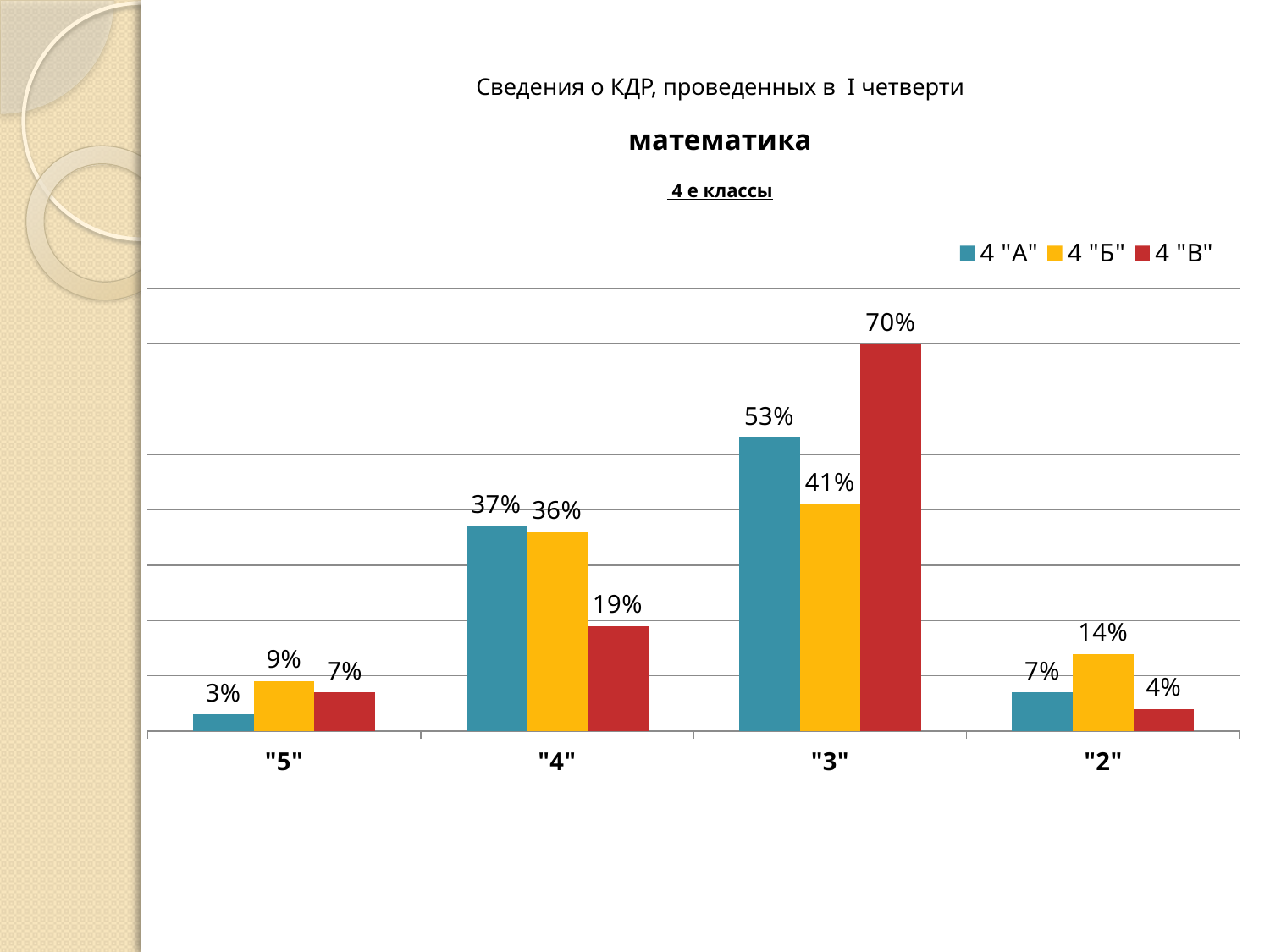
What kind of chart is shown on the slide? bar chart Which grade category has the lowest value for 4 "В"? "2" How many grade categories are shown on the x axis? 4 What is the value for 4 "А" in the "5" category? 3% What is the difference between 4 "Б" and 4 "В" in the "2" category? 10% Which series is shown in red in the legend? 4 "В" Which grade category has the highest value for 4 "А"? "3" What is the difference between 4 "В" and 4 "А" in the "3" category? 17% How many series does the legend list? 3 What percentage of 4 "В" received a "3"? 70% What is the value for 4 "Б" in the "2" category? 14% Which is larger in the "4" category: 4 "А" or 4 "В"? 4 "А"